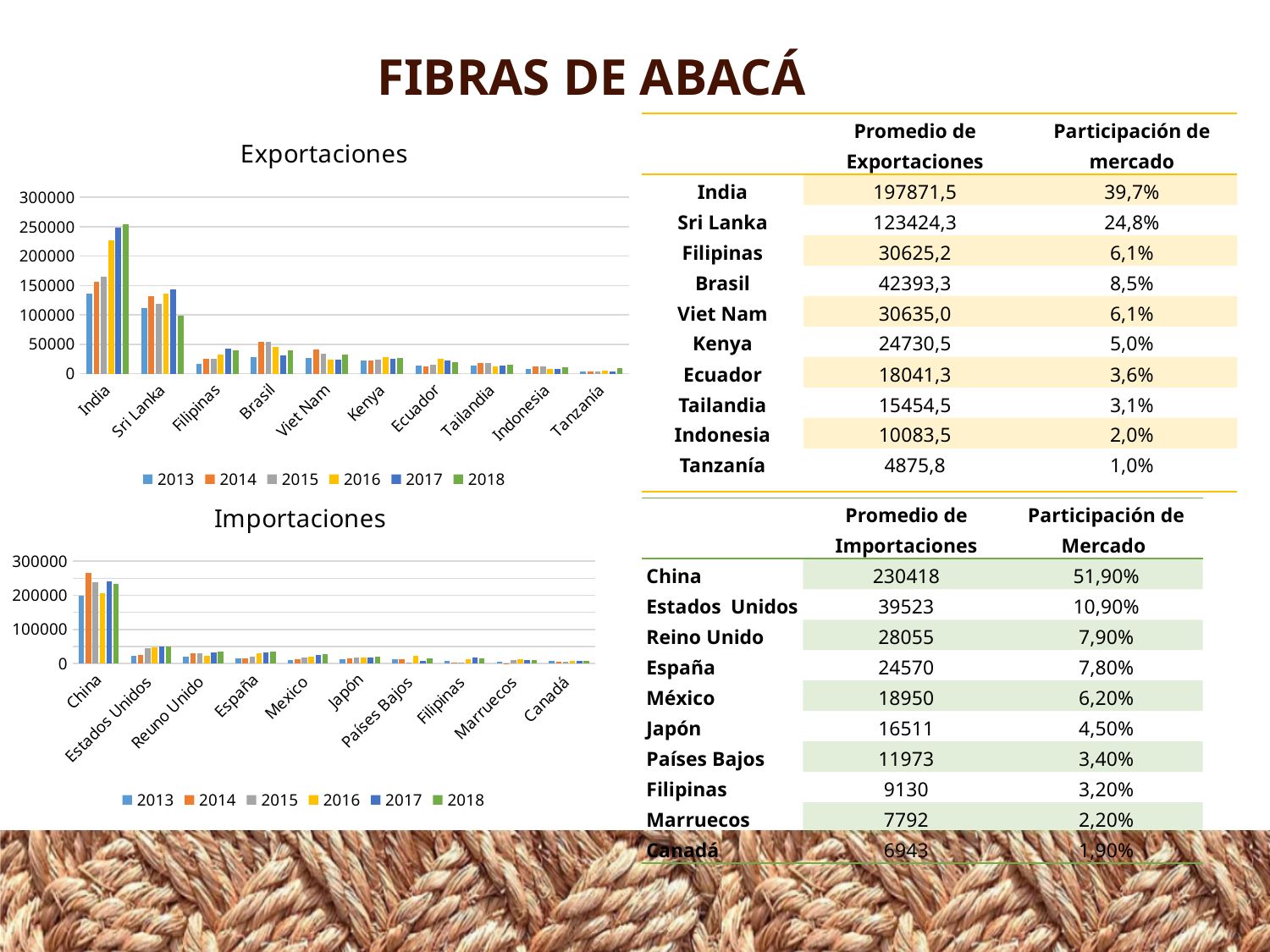
In the Exportaciones chart, which is larger, the 2018 value for India or the 2018 value for Sri Lanka? India In the Exportaciones chart, is the 2018 value for Filipinas greater or less than 50000? less How many series does the legend of the Exportaciones chart list? 6 How many countries are shown on the x axis of the Exportaciones chart? 10 In the Exportaciones chart, which country has the lowest bars? Tanzanía In the Exportaciones chart, which country has the highest bars? India In the Importaciones chart, is the 2014 value for China greater or less than 200000? greater What kind of chart is the Importaciones chart? bar chart In the Exportaciones chart, is the 2013 value for India greater or less than 100000? greater What kind of chart is the Exportaciones chart? bar chart How many countries are shown on the x axis of the Importaciones chart? 10 In the Importaciones chart, which country has the highest bars? China